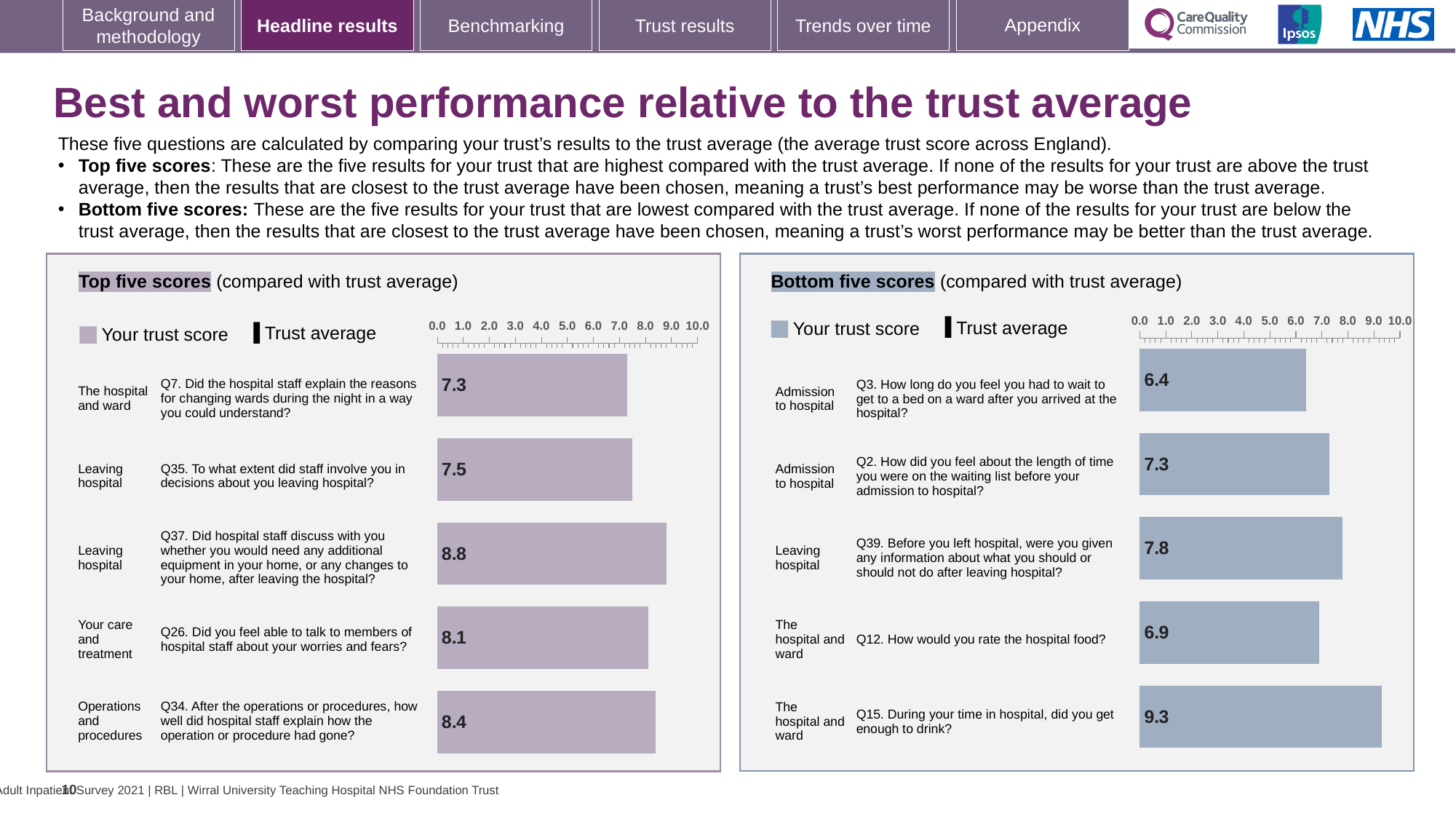
In the Top five scores chart, what is the trust score for Q35 (To what extent did staff involve you in decisions about you leaving hospital)? 7.5 In the Bottom five scores chart, which question has the highest trust score? Q15 In the Top five scores chart, which question has the highest trust score? Q37 How many entries does the legend of the Bottom five scores chart list? 2 In the Top five scores chart, what is the difference between the scores for Q37 and Q7? 1.5 What type of chart is used in the Top five scores panel? Bar chart In the Bottom five scores chart, what is the trust score for Q12 (How would you rate the hospital food)? 6.9 How many bars are shown in the Top five scores chart? 5 In the Bottom five scores chart, which has the larger score, Q15 or Q39? Q15 In the Top five scores chart, what is the trust score for Q26 about talking to hospital staff about worries and fears? 8.1 In the Bottom five scores chart, which question has the lowest trust score? Q3 In the Bottom five scores chart, is the score for Q3 greater or less than 7.0? less